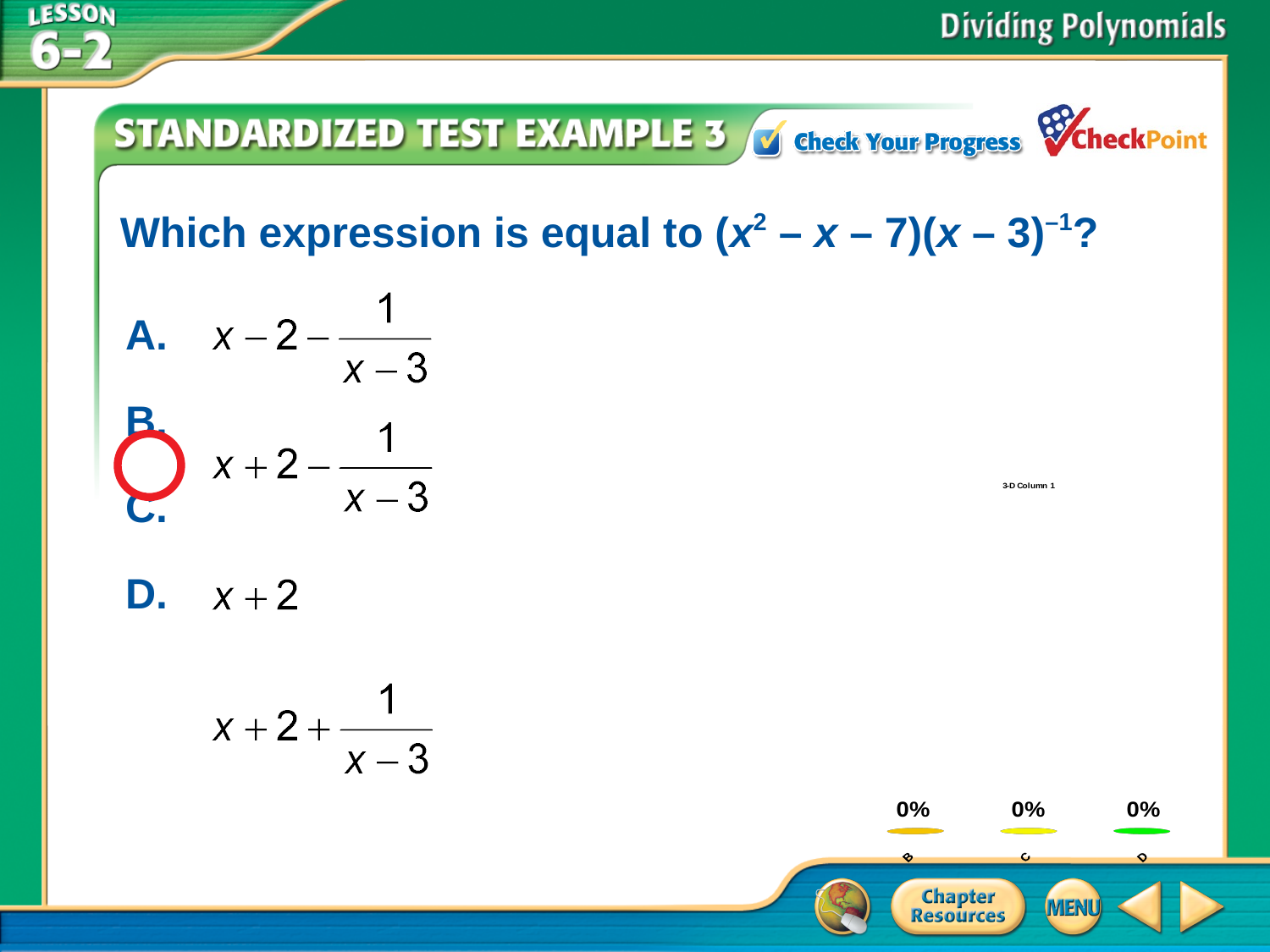
What value is shown for category C in the chart at the bottom right? 0% What kind of chart is shown at the bottom right of the slide? bar chart What is the difference between the values for C and D in the chart? 0% What value is shown for category B in the chart at the bottom right? 0% What value is shown for category D in the chart at the bottom right? 0% What is the difference between the values for B and D in the chart? 0%